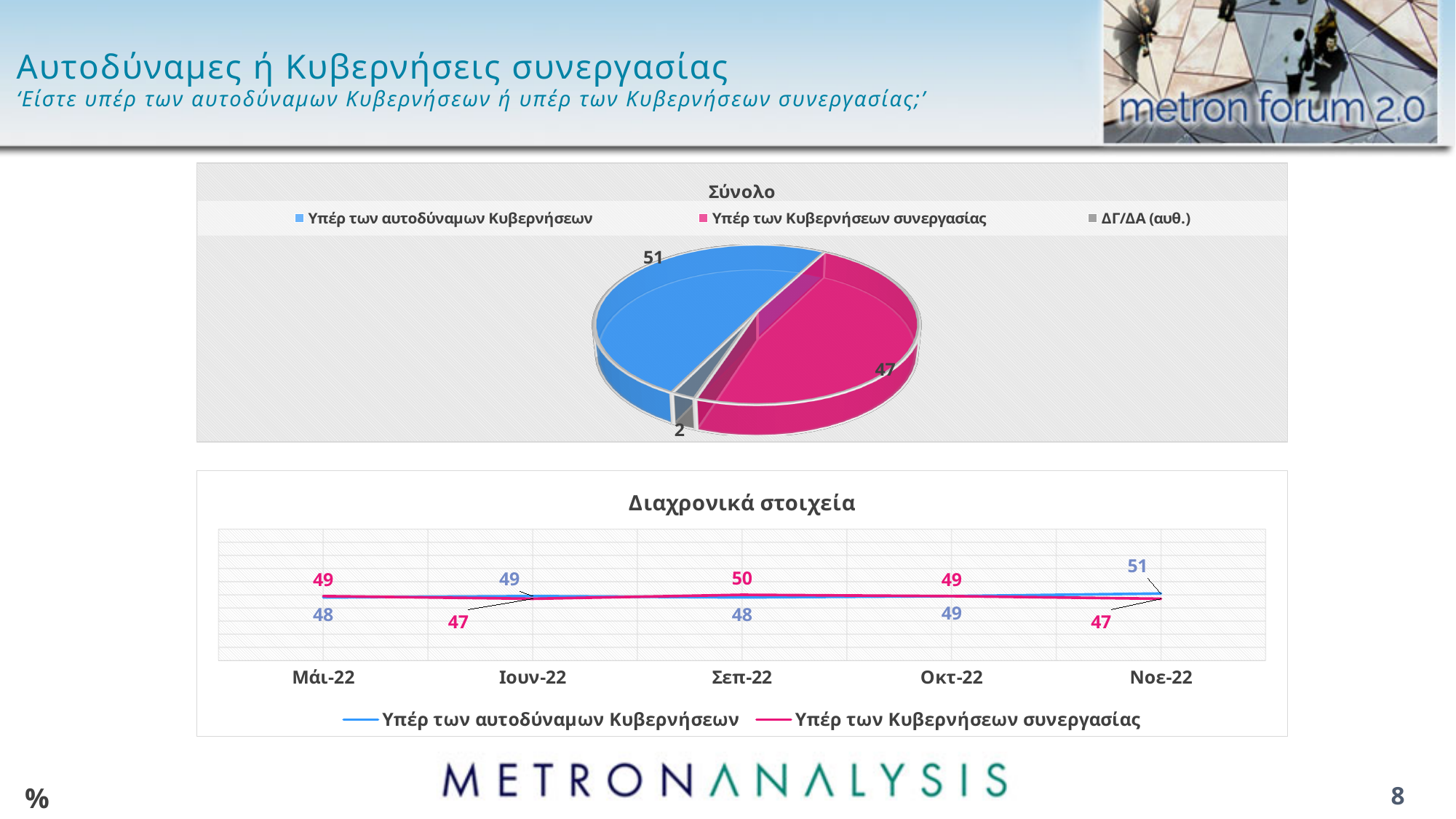
In the 'Σύνολο' pie chart, what is the value for 'ΔΓ/ΔΑ (αυθ.)'? 2 In the 'Διαχρονικά στοιχεία' chart, what is the value for 'Υπέρ των Κυβερνήσεων συνεργασίας' in Σεπ-22? 50 In the 'Διαχρονικά στοιχεία' chart, what is the value for 'Υπέρ των αυτοδύναμων Κυβερνήσεων' in Νοε-22? 51 In the 'Σύνολο' pie chart, what is the value for 'Υπέρ των αυτοδύναμων Κυβερνήσεων'? 51 In the 'Διαχρονικά στοιχεία' chart, what is the difference between the two series in Νοε-22? 4 In the 'Διαχρονικά στοιχεία' chart, how many time points are shown on the x axis? 5 How many slices does the 'Σύνολο' pie chart have? 3 In the 'Σύνολο' pie chart, which category has the smallest slice? ΔΓ/ΔΑ (αυθ.) In the 'Σύνολο' pie chart, what is the difference between 'Υπέρ των αυτοδύναμων Κυβερνήσεων' and 'Υπέρ των Κυβερνήσεων συνεργασίας'? 4 In the 'Διαχρονικά στοιχεία' chart, which series has the higher value in Ιουν-22? Υπέρ των αυτοδύναμων Κυβερνήσεων What type of chart is the 'Διαχρονικά στοιχεία' chart? Line chart How many series does the legend of the 'Διαχρονικά στοιχεία' chart list? 2